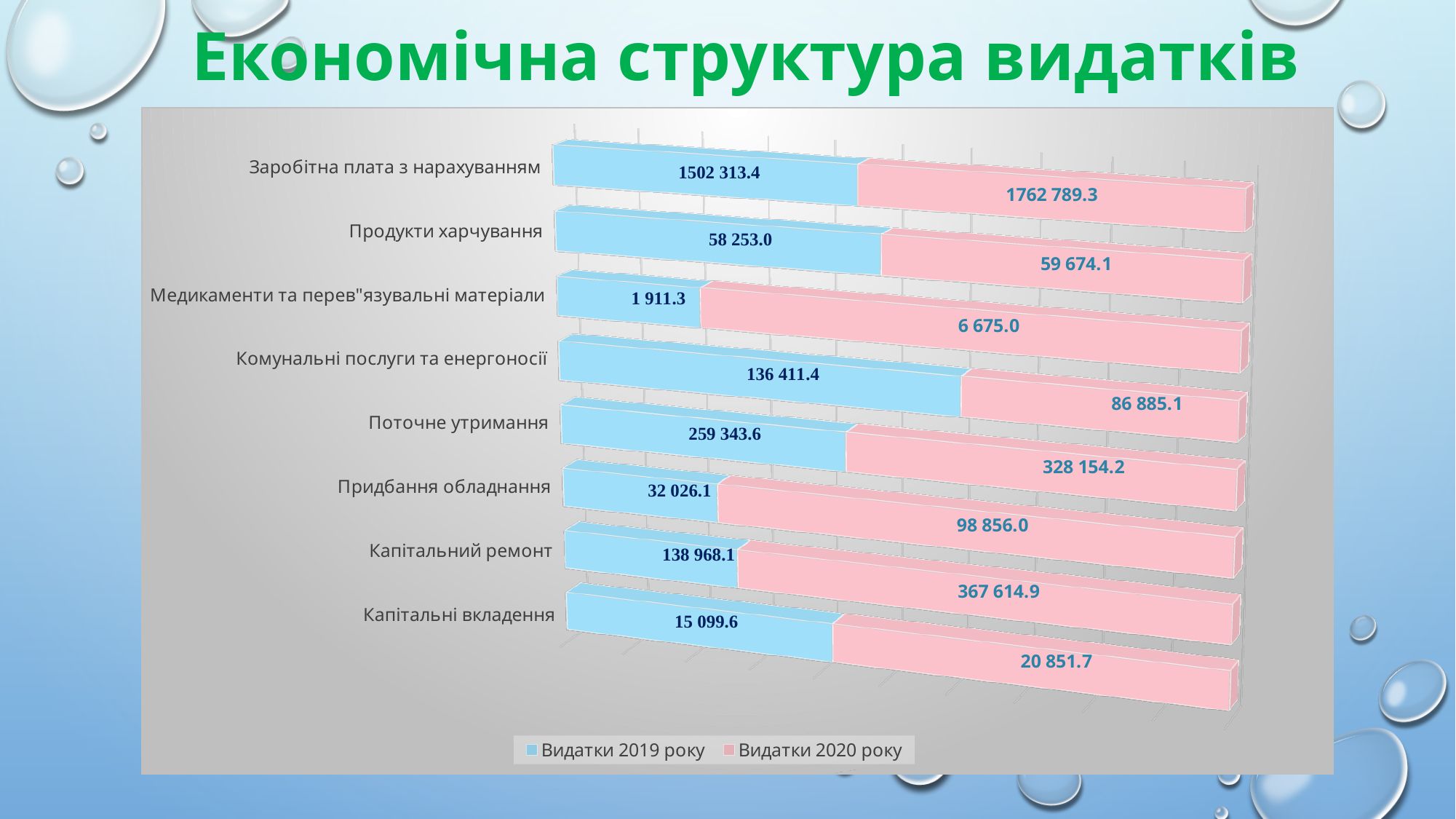
How many categories are shown on the chart? 8 For Комунальні послуги та енергоносії, which series has the larger value, Видатки 2019 року or Видатки 2020 року? Видатки 2019 року Which category has the highest value in the Видатки 2020 року series? Заробітна плата з нарахуванням What is the difference between the Видатки 2019 року and Видатки 2020 року values for Комунальні послуги та енергоносії? 49 526.3 What is the value for Заробітна плата з нарахуванням in the Видатки 2019 року series? 1502 313.4 What is the value for Капітальний ремонт in the Видатки 2020 року series? 367 614.9 Which category has the lowest value in the Видатки 2019 року series? Медикаменти та перев"язувальні матеріали How many series does the legend list? 2 What kind of chart is shown on the slide? Bar chart What is the value for Придбання обладнання in the Видатки 2020 року series? 98 856.0 What is the value for Медикаменти та перев"язувальні матеріали in the Видатки 2019 року series? 1 911.3 What is the difference between the Видатки 2020 року and Видатки 2019 року values for Капітальний ремонт? 228 646.8